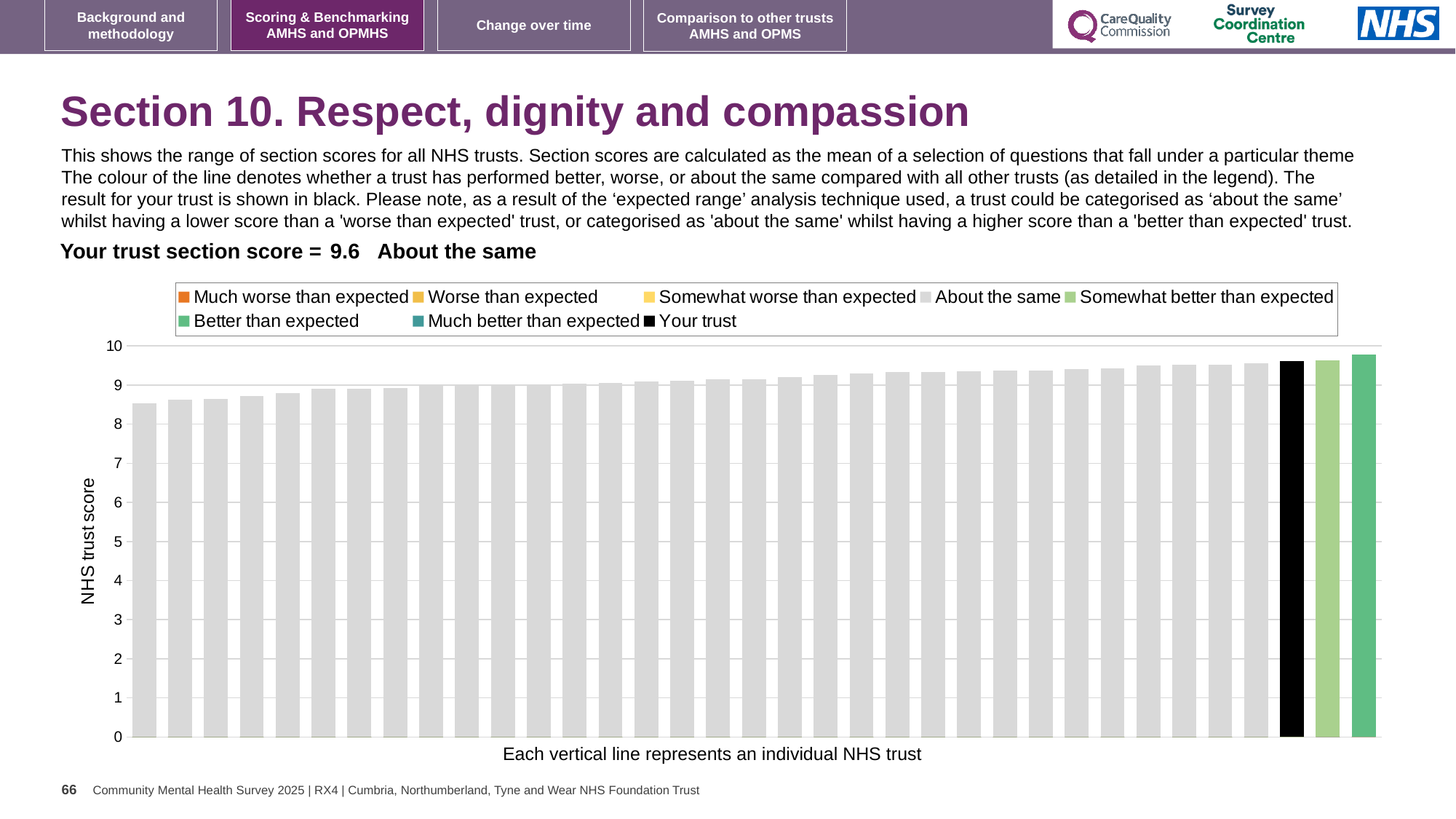
Which legend category does the shortest bar belong to? About the same Which category is your trust placed in for this section? About the same What kind of chart is shown on the slide? Bar chart Which legend category does the tallest bar belong to? Better than expected What is the section score for your trust (the black bar)? 9.6 Is the black 'Your trust' bar taller or shorter than the leftmost bar? Taller How many entries does the chart legend list? 8 Is the value of the black 'Your trust' bar greater or less than 9? greater Do the bar values rise or fall from left to right along the x axis? Rise Is the value of the leftmost bar greater or less than 9? less What is the label on the vertical axis of the chart? NHS trust score Is the value of the leftmost bar greater or less than 8? greater